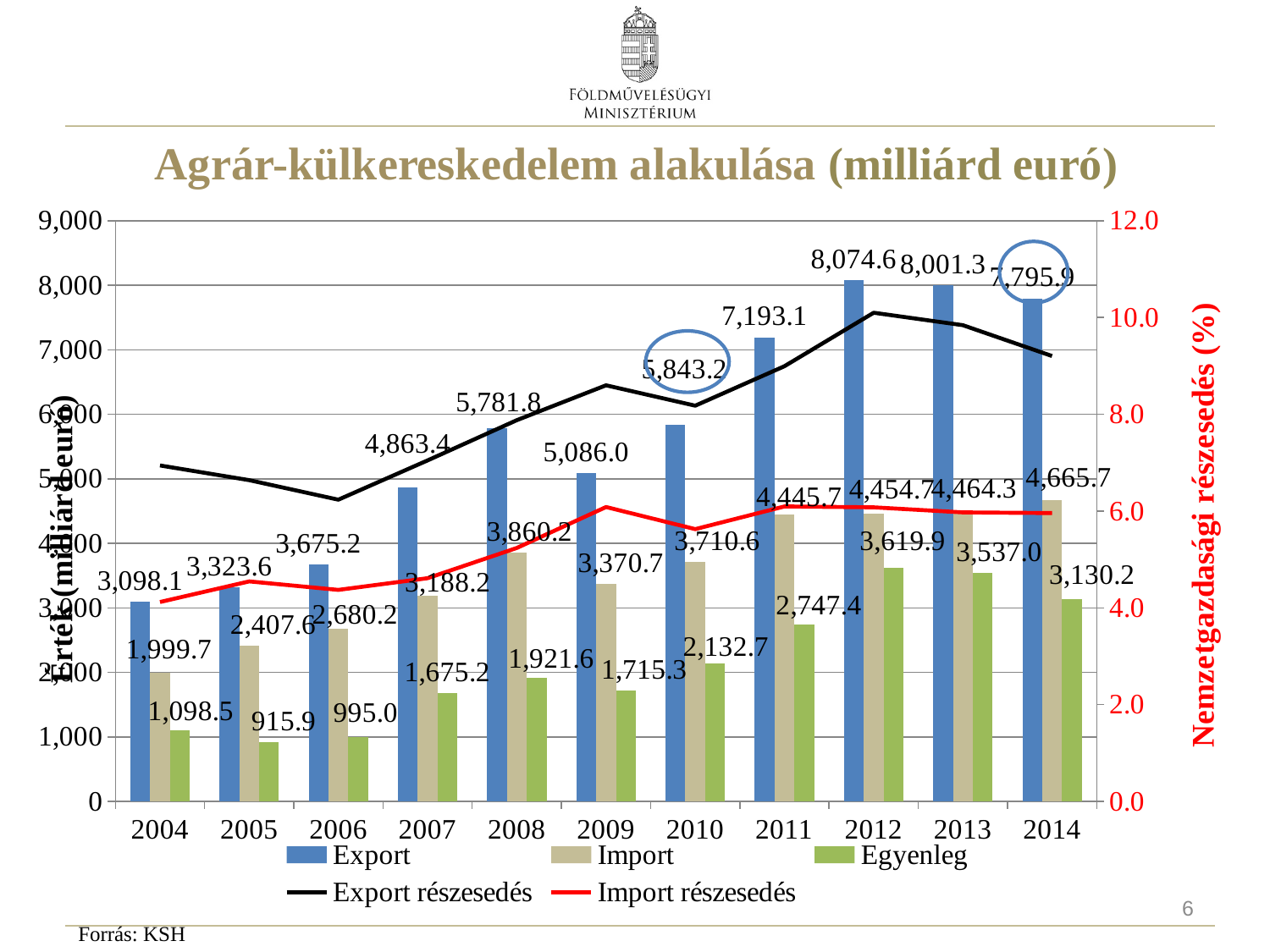
In which year is the Egyenleg value lowest? 2005 Which year has the larger Egyenleg value, 2012 or 2013? 2012 What is the Egyenleg value for 2005? 915.9 How many series does the legend list? 5 Does the Export value rise or fall from 2004 to 2012? rise Is the Export részesedés value for 2012 greater or less than 8.0? greater What is the difference between the Export and Import values in 2014? 3,130.2 What kind of chart is shown on the slide? bar and line chart In which year is the Export value highest? 2012 What is the Export value for 2012? 8,074.6 What is the Import value for 2008? 3,860.2 How many years are shown on the x axis? 11